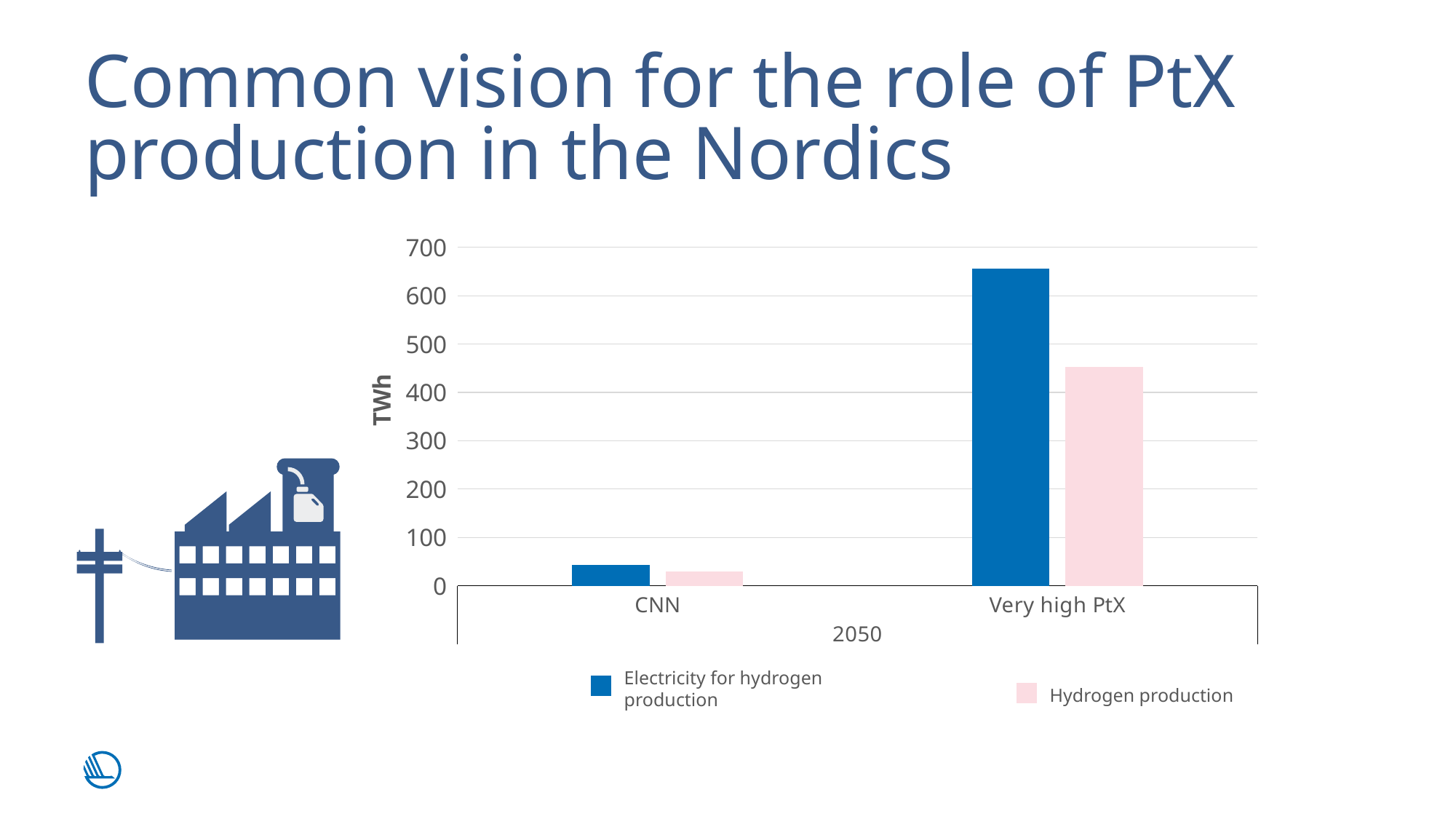
How many series does the legend list? 2 Is the value for Electricity for hydrogen production in the Very high PtX scenario greater or less than 600? greater Is the value for Electricity for hydrogen production in the CNN scenario greater or less than 100? less What kind of chart is shown on the slide? bar chart What unit is shown on the y axis of the chart? TWh Which is larger: Hydrogen production for CNN or Hydrogen production for Very high PtX? Very high PtX In the Very high PtX scenario, which is larger: Electricity for hydrogen production or Hydrogen production? Electricity for hydrogen production How many scenario categories are shown on the x axis? 2 What year is shown beneath the scenario labels on the x axis? 2050 Is the value for Hydrogen production in the Very high PtX scenario greater or less than 500? less Which scenario has the highest value for Electricity for hydrogen production? Very high PtX Which scenario has the lowest value for Hydrogen production? CNN